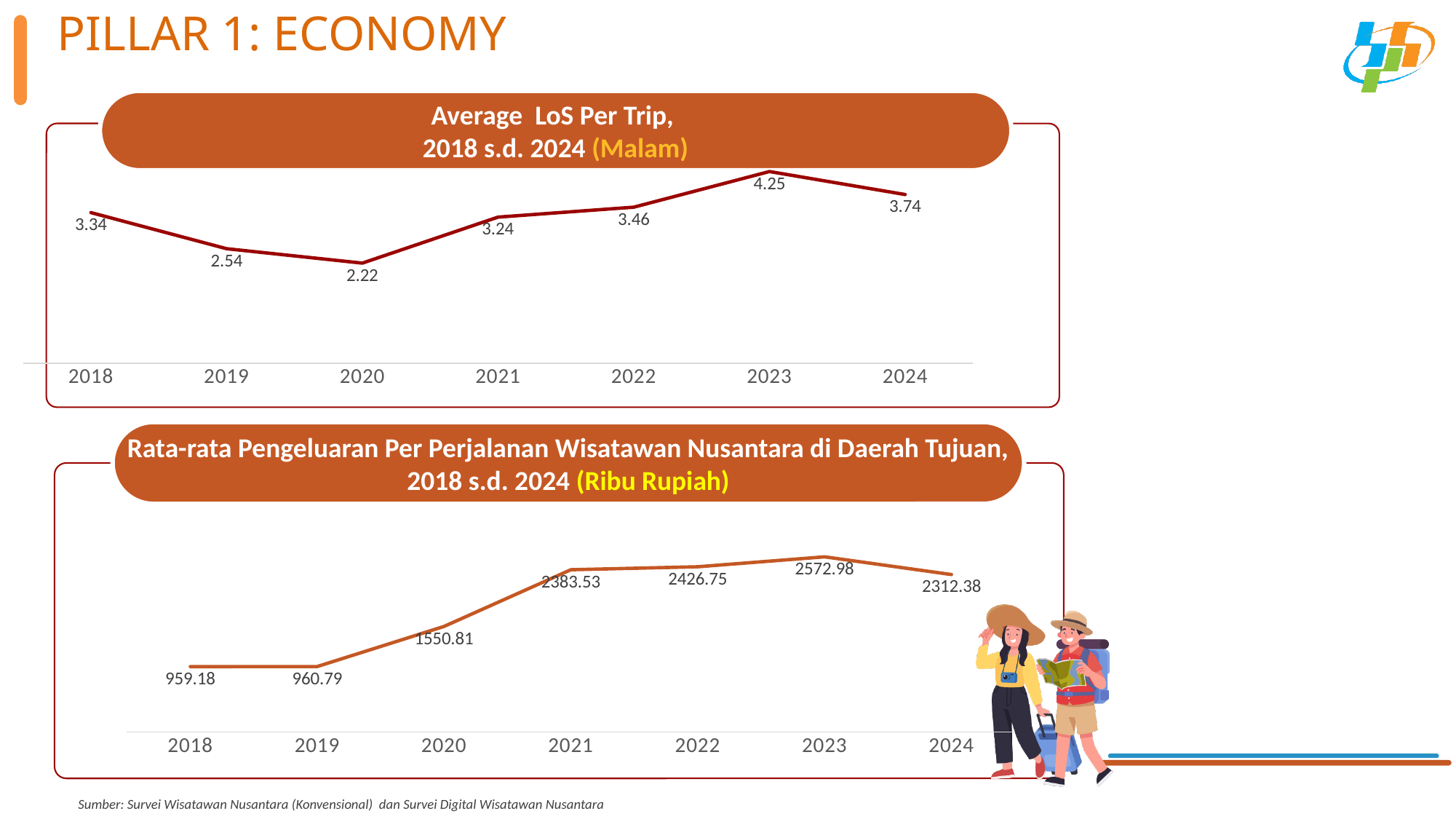
In the 'Rata-rata Pengeluaran Per Perjalanan' chart, what is the difference between the 2020 value and the 2019 value? 590.02 What kind of chart is the 'Average LoS Per Trip' chart? Line chart In the 'Rata-rata Pengeluaran Per Perjalanan' chart, which year has the highest value? 2023 In the 'Average LoS Per Trip' chart, what is the difference between the 2023 value and the 2024 value? 0.51 In the 'Average LoS Per Trip' chart, how many years are plotted? 7 In the 'Rata-rata Pengeluaran Per Perjalanan' chart, which year has the lowest value? 2018 In the 'Rata-rata Pengeluaran Per Perjalanan' chart, is the value for 2020 larger or the value for 2022? 2022 In the 'Average LoS Per Trip' chart, what is the value for 2020? 2.22 In the 'Average LoS Per Trip' chart, which year has the lowest value? 2020 In the 'Rata-rata Pengeluaran Per Perjalanan' chart, what is the value for 2021? 2383.53 In the 'Average LoS Per Trip' chart, which year has the highest value? 2023 What unit is shown in the title of the bottom chart? Ribu Rupiah